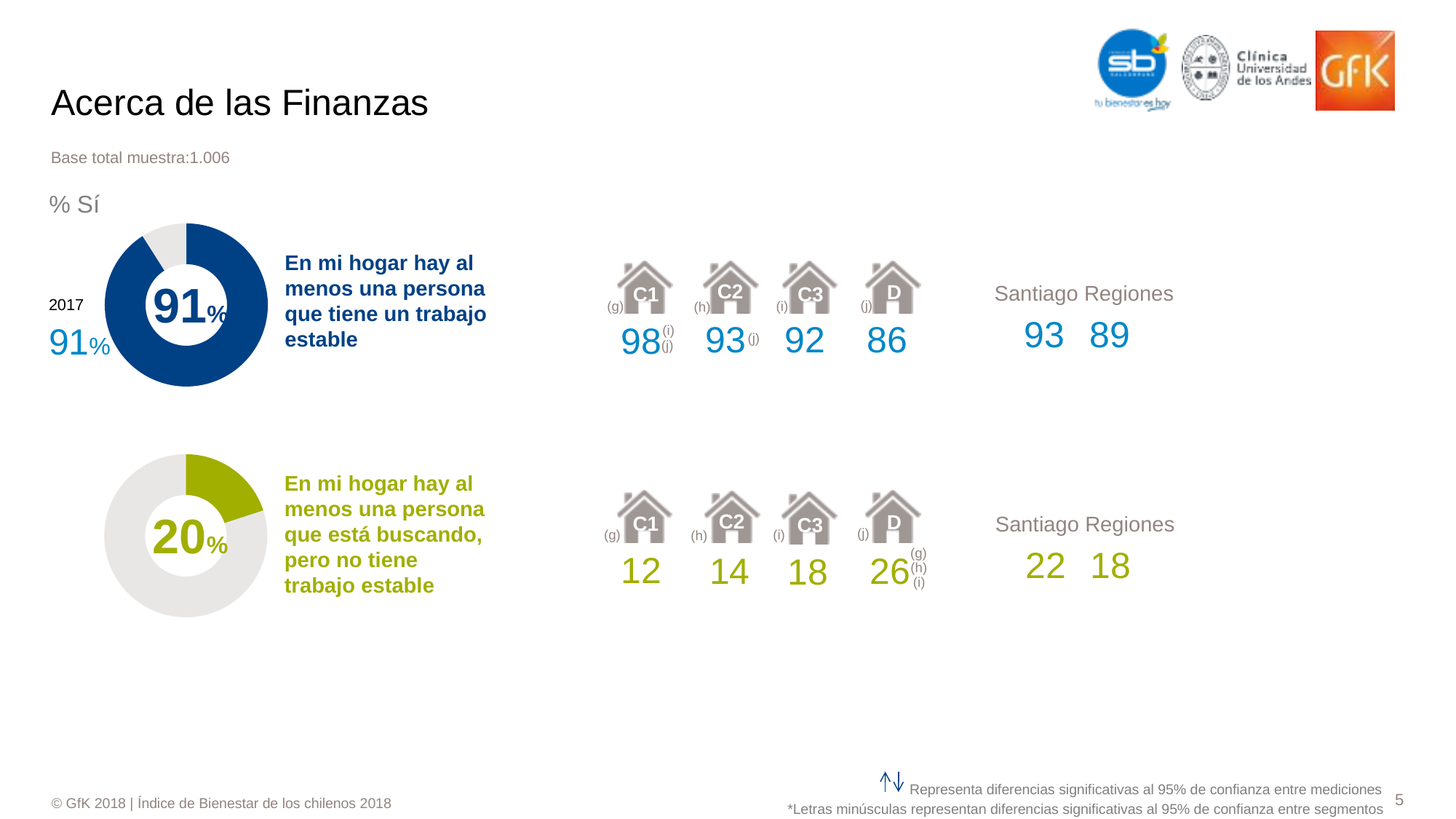
In the top donut chart, what share of the ring is filled in dark blue? 91% Which donut chart shows the larger value, the top one (trabajo estable) or the bottom one (buscando trabajo)? The top one (91%) What is the difference between the value in the top donut chart (91%) and the value in the bottom donut chart (20%)? 71 percentage points Is the value shown in the bottom donut chart greater or less than 50%? less For the top chart's statement (trabajo estable), which segment has the highest value among C1, C2, C3 and D? C1 (98) In the top donut chart, what percentage is shown in the centre? 91% How many donut charts are shown on the slide? 2 In the bottom donut chart, what share of the ring is filled in green? 20% What kind of chart is used to show the 91% value for 'En mi hogar hay al menos una persona que tiene un trabajo estable'? Donut (pie) chart In the bottom donut chart, what percentage is shown in the centre? 20% What year label appears next to the top donut chart? 2017 What colour is the filled segment of the bottom donut chart? Green